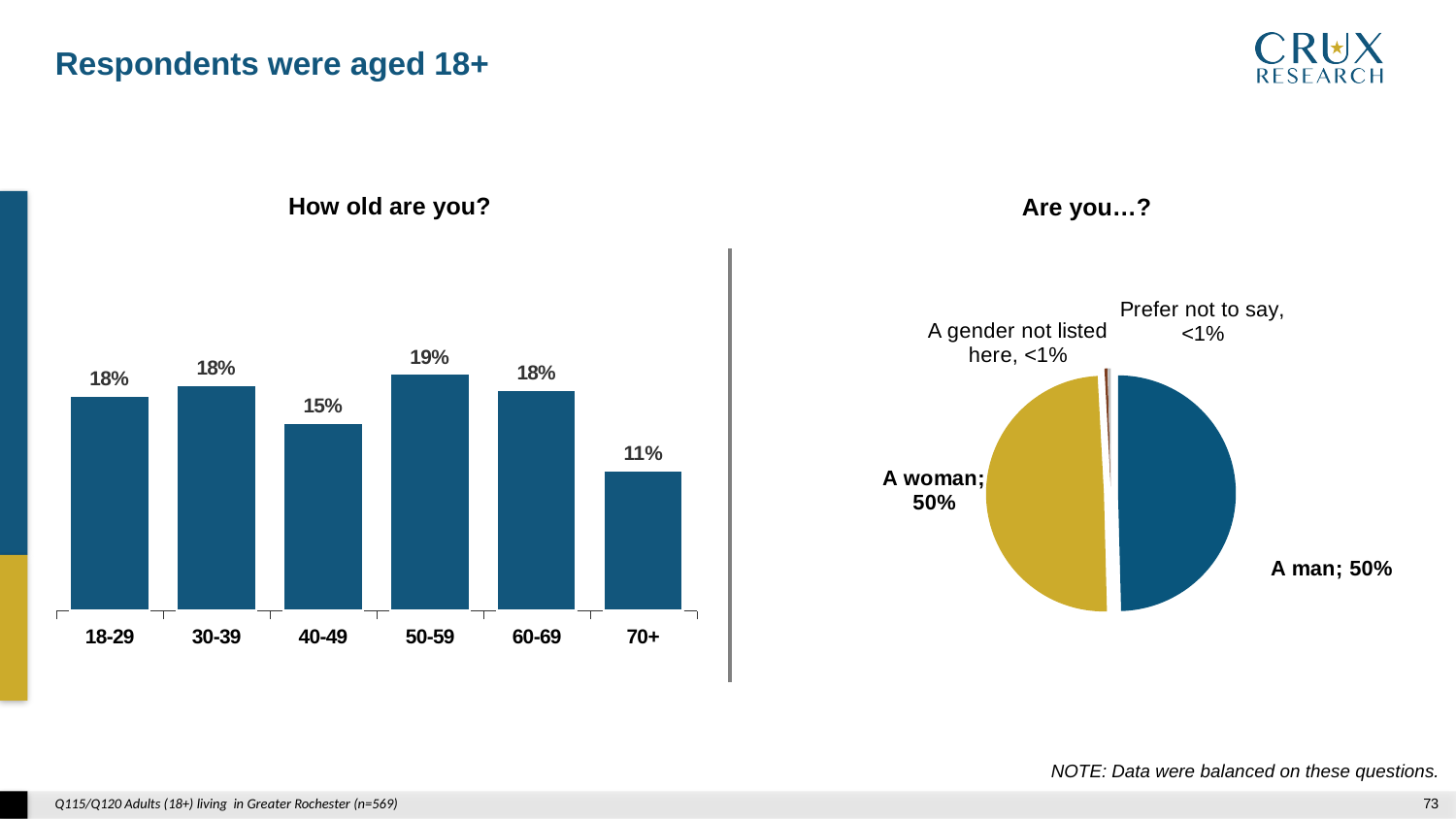
How many slices does the 'Are you…?' pie chart have? 4 In the 'Are you…?' chart, what share of respondents are a woman? 50% In the 'How old are you?' chart, what is the difference between the 50-59 and 70+ percentages? 8% In the 'How old are you?' chart, which age group has the highest percentage? 50-59 In the 'Are you…?' chart, what share of respondents chose 'Prefer not to say'? <1% In the 'How old are you?' chart, which age group has the lowest percentage? 70+ In the 'How old are you?' chart, what percentage of respondents are aged 40-49? 15% In the 'How old are you?' chart, which is larger: the value for 40-49 or the value for 60-69? 60-69 How many age groups are shown in the 'How old are you?' chart? 6 What type of chart is the 'Are you…?' chart? Pie chart What type of chart is the 'How old are you?' chart? Bar chart In the 'How old are you?' chart, what percentage of respondents are aged 70+? 11%